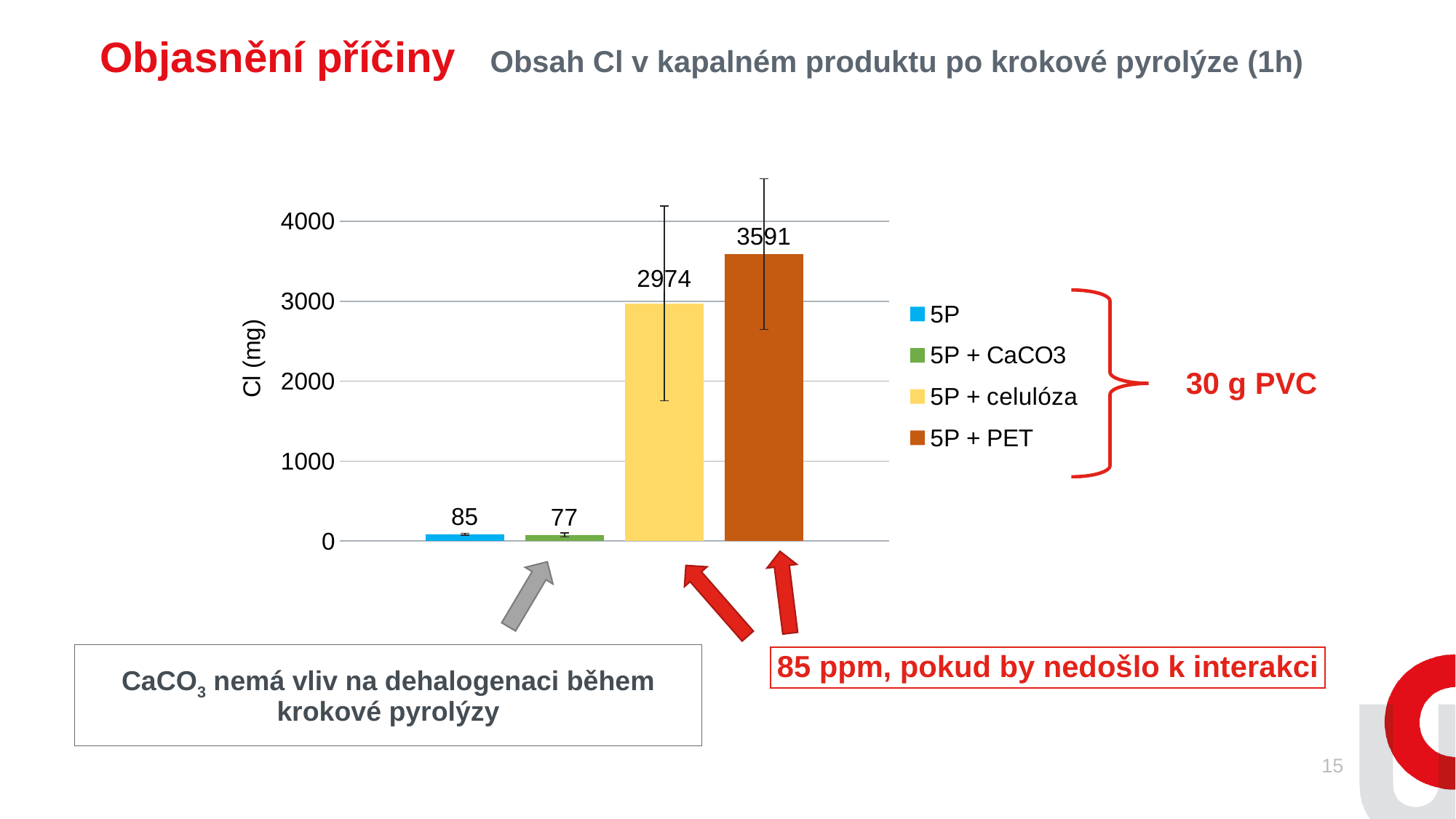
What is the label of the vertical axis? Cl (mg) Which has a larger Cl (mg) value, 5P + celulóza or 5P + CaCO3? 5P + celulóza What is the difference in Cl (mg) between 5P + PET and 5P + celulóza? 617 Which series has the highest Cl (mg) value? 5P + PET What is the Cl (mg) value for 5P + PET? 3591 What kind of chart is shown on the slide? bar chart How many series does the legend list? 4 What is the Cl (mg) value for 5P + CaCO3? 77 Which series has the lowest Cl (mg) value? 5P + CaCO3 What is the Cl (mg) value for 5P + celulóza? 2974 What is the difference in Cl (mg) between 5P and 5P + CaCO3? 8 What is the Cl (mg) value for 5P? 85